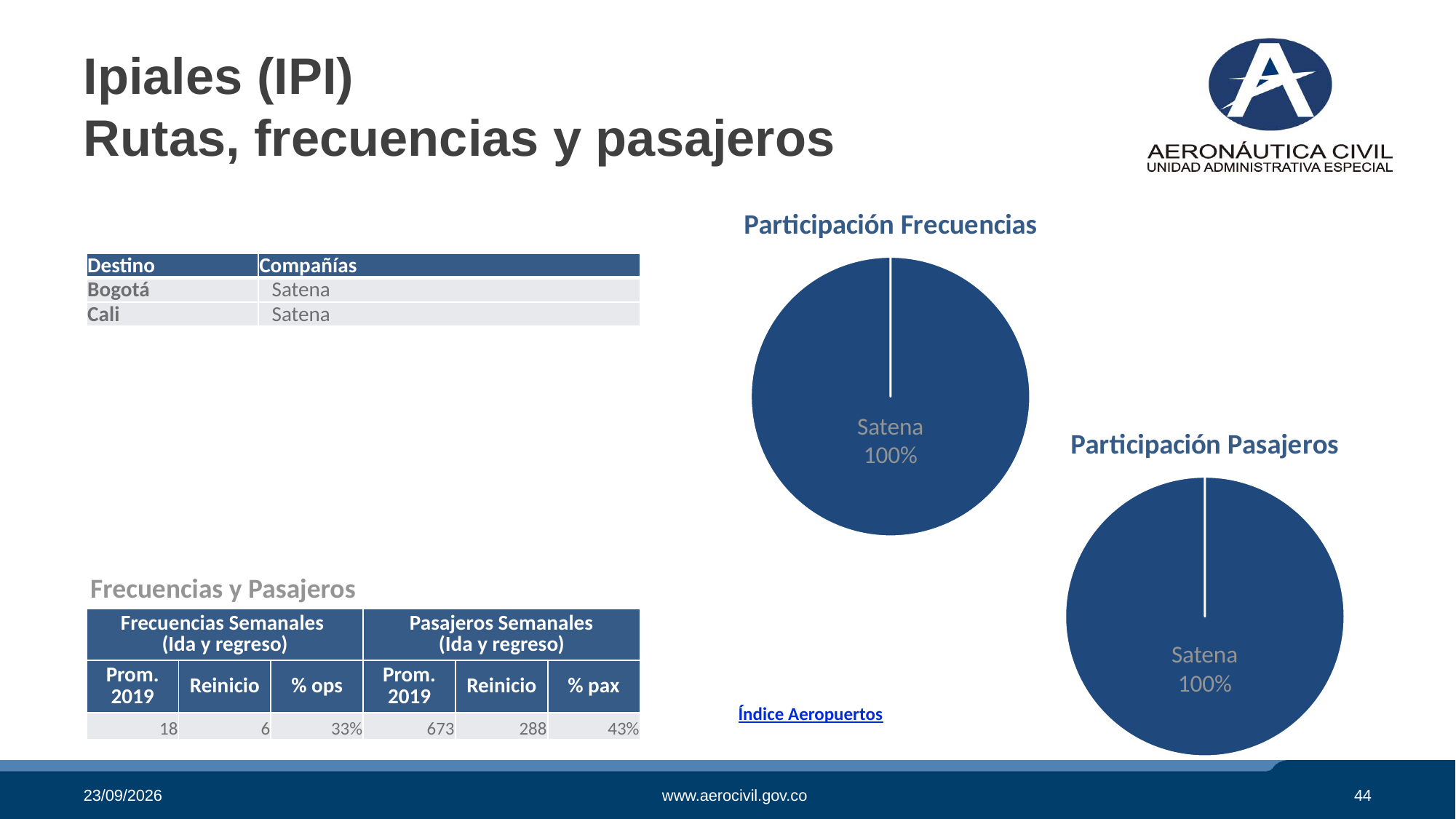
What is the title of the pie chart positioned at the top right of the slide? Participación Frecuencias In the 'Participación Frecuencias' chart, is Satena's share greater or less than 50%? greater Which company is shown in the 'Participación Pasajeros' pie chart? Satena In the 'Participación Pasajeros' chart, which company has the largest share? Satena How many slices does the 'Participación Frecuencias' pie chart have? 1 How many slices does the 'Participación Pasajeros' pie chart have? 1 What kind of chart is 'Participación Pasajeros'? Pie chart What kind of chart is 'Participación Frecuencias'? Pie chart Which company is shown in the 'Participación Frecuencias' pie chart? Satena In the 'Participación Pasajeros' chart, what share does Satena hold? 100% What is the title of the pie chart positioned at the bottom right of the slide? Participación Pasajeros In the 'Participación Frecuencias' chart, what share does Satena hold? 100%